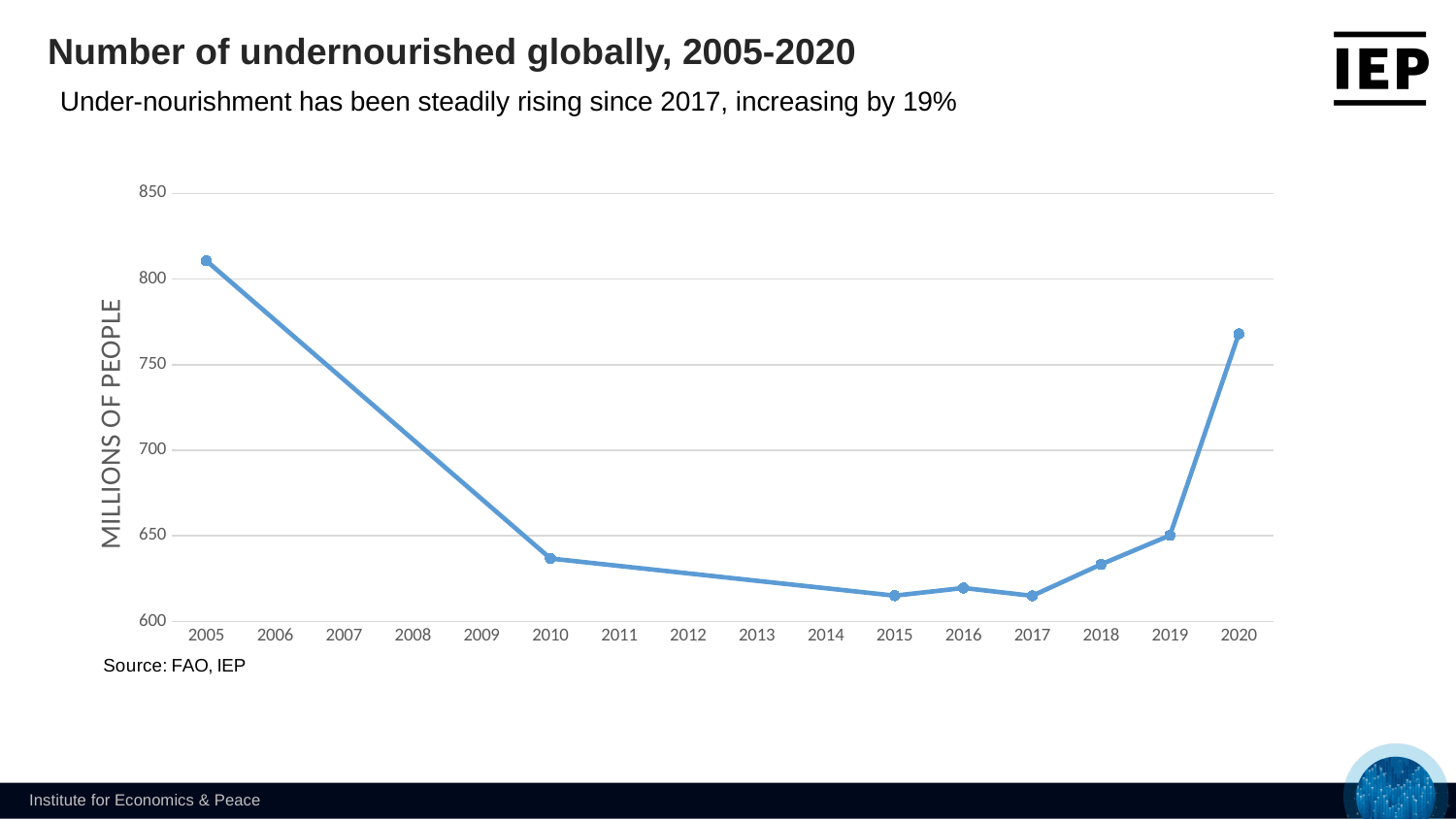
How many data points are plotted on the line? 8 Which is larger, the value for 2010 or the value for 2020? 2020 What kind of chart is shown on the slide? line chart Is the value for 2010 greater or less than 650? less What is the label on the vertical axis? MILLIONS OF PEOPLE Is the value for 2005 greater or less than 800? greater Is the value for 2015 greater or less than 650? less Do the values rise or fall from 2017 to 2020? rise Do the values rise or fall from 2005 to 2015? fall Which is larger, the value for 2005 or the value for 2020? 2005 Which year has the highest number of undernourished people? 2005